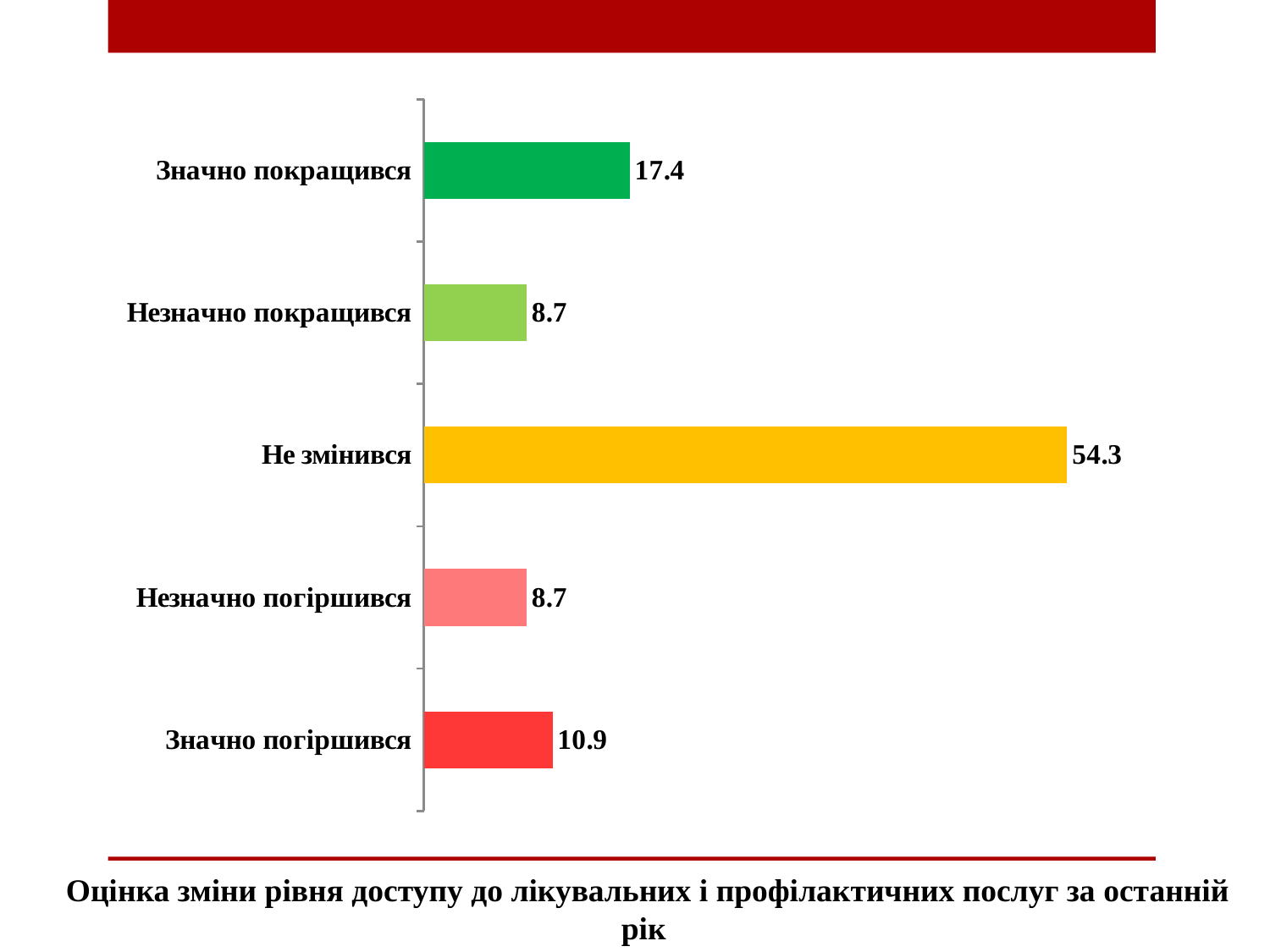
How many categories are shown in the chart? 5 What kind of chart is shown on the slide? Bar chart What is the difference between the values for "Не змінився" and "Значно покращився"? 36.9 What colour is the bar for "Не змінився"? Yellow What is the value for "Не змінився"? 54.3 Which is larger, the value for "Значно погіршився" or the value for "Незначно погіршився"? Значно погіршився What is the value for "Незначно покращився"? 8.7 What is the value for "Значно покращився"? 17.4 What is the value for "Значно погіршився"? 10.9 Which is larger, the value for "Значно покращився" or the value for "Значно погіршився"? Значно покращився What is the difference between the values for "Значно покращився" and "Значно погіршився"? 6.5 Which category has the highest value? Не змінився